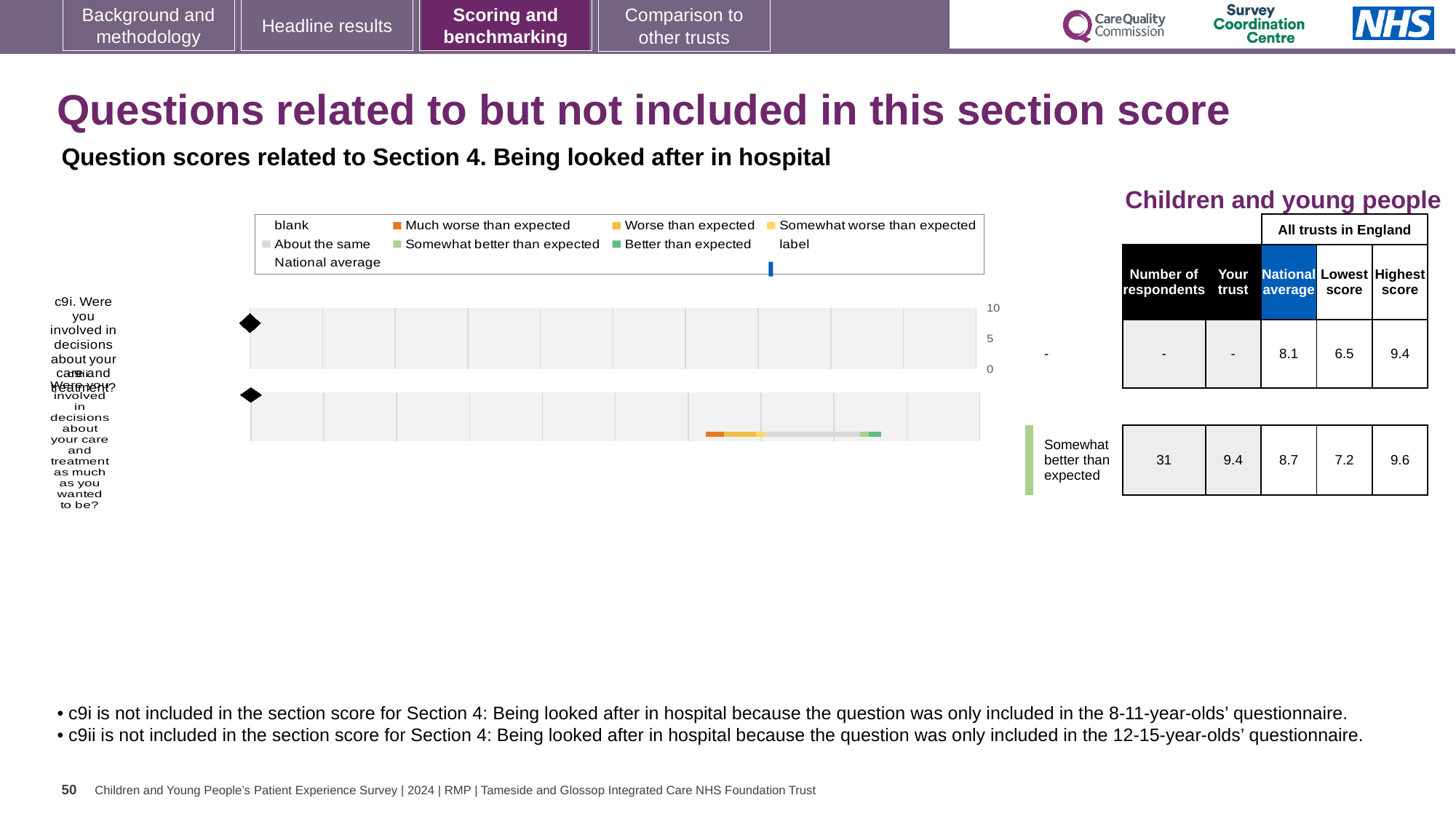
What benchmark category is shown for question c9ii? Somewhat better than expected Which is larger for question c9ii: the trust's score or the national average? the trust's score What is the highest score across all trusts in England for question c9ii? 9.6 What is the national average score for question c9ii? 8.7 What kind of chart is shown on the slide? bar chart What is the 'Your trust' score for question c9ii? 9.4 What is the lowest score across all trusts in England for question c9i? 6.5 What is the national average score for question c9i? 8.1 Which question has the higher national average, c9i or c9ii? c9ii How many respondents answered question c9ii? 31 What is the difference between the trust's score and the national average for question c9ii? 0.7 How many questions (rows) are plotted in the chart? 2